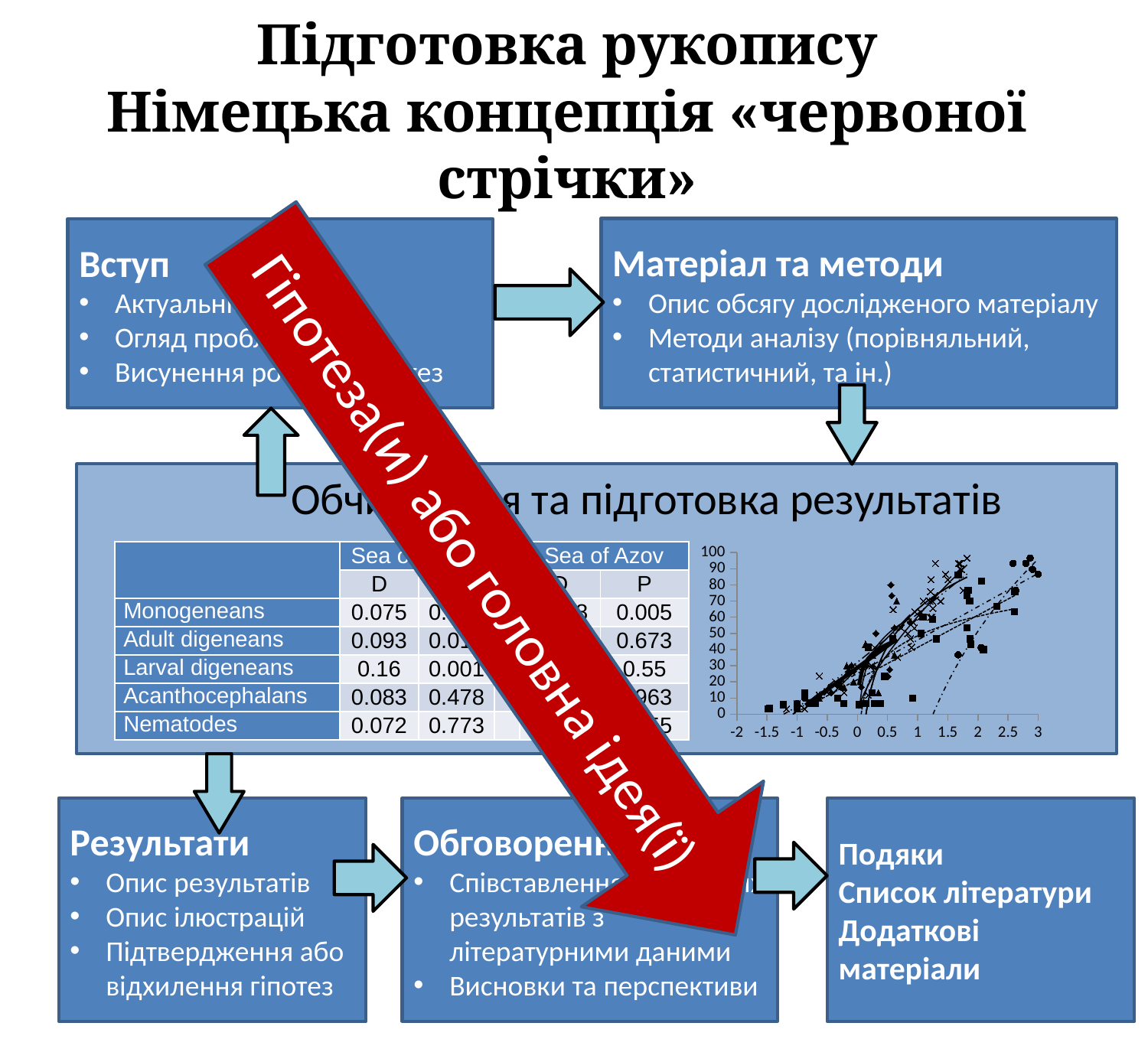
What is the lowest tick value shown on the horizontal axis of the scatter chart? -2 In the scatter chart on the slide, do the plotted values generally rise or fall as the x-axis value increases? rise What kind of chart is shown on the right side of the middle panel of the slide? scatter chart What is the highest tick value shown on the vertical axis of the scatter chart? 100